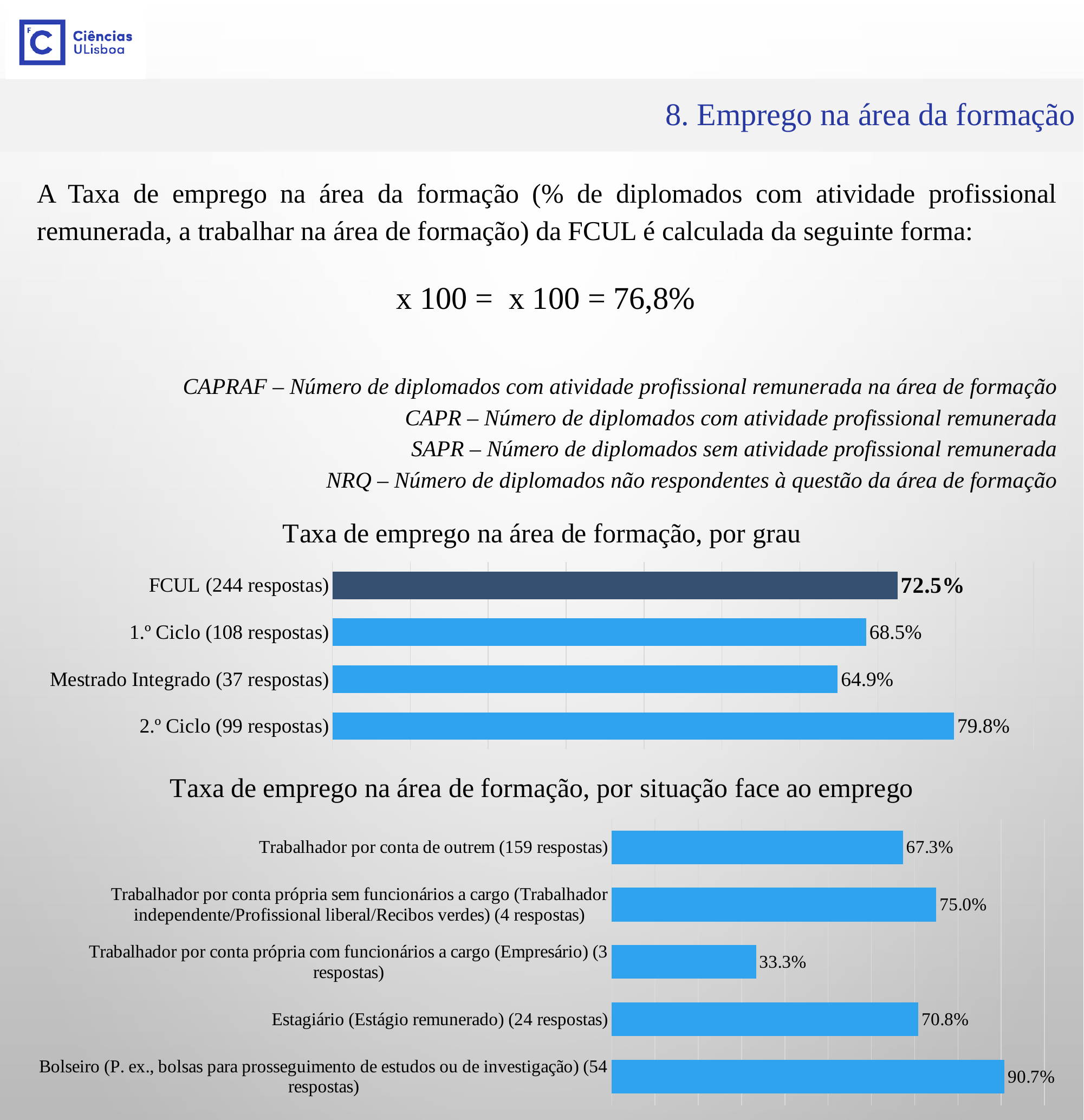
In the chart 'Taxa de emprego na área de formação, por situação face ao emprego', which is larger: the value for Trabalhador por conta de outrem or the value for Trabalhador por conta própria sem funcionários a cargo? Trabalhador por conta própria sem funcionários a cargo In the chart 'Taxa de emprego na área de formação, por situação face ao emprego', which category has the lowest value? Trabalhador por conta própria com funcionários a cargo (Empresário) (3 respostas) In the chart 'Taxa de emprego na área de formação, por grau', how many categories are shown? 4 In the chart 'Taxa de emprego na área de formação, por grau', what is the difference between the values for 2.º Ciclo and 1.º Ciclo? 11.3% In the chart 'Taxa de emprego na área de formação, por grau', what is the value for FCUL (244 respostas)? 72.5% In the chart 'Taxa de emprego na área de formação, por situação face ao emprego', what is the value for Estagiário (Estágio remunerado) (24 respostas)? 70.8% What type of chart is 'Taxa de emprego na área de formação, por situação face ao emprego'? Bar chart In the chart 'Taxa de emprego na área de formação, por grau', which category has the highest value? 2.º Ciclo (99 respostas) In the chart 'Taxa de emprego na área de formação, por situação face ao emprego', what is the value for Bolseiro (54 respostas)? 90.7% In the chart 'Taxa de emprego na área de formação, por grau', what is the value for 2.º Ciclo (99 respostas)? 79.8% In the chart 'Taxa de emprego na área de formação, por situação face ao emprego', how many categories are shown? 5 In the chart 'Taxa de emprego na área de formação, por grau', which category has the lowest value? Mestrado Integrado (37 respostas)